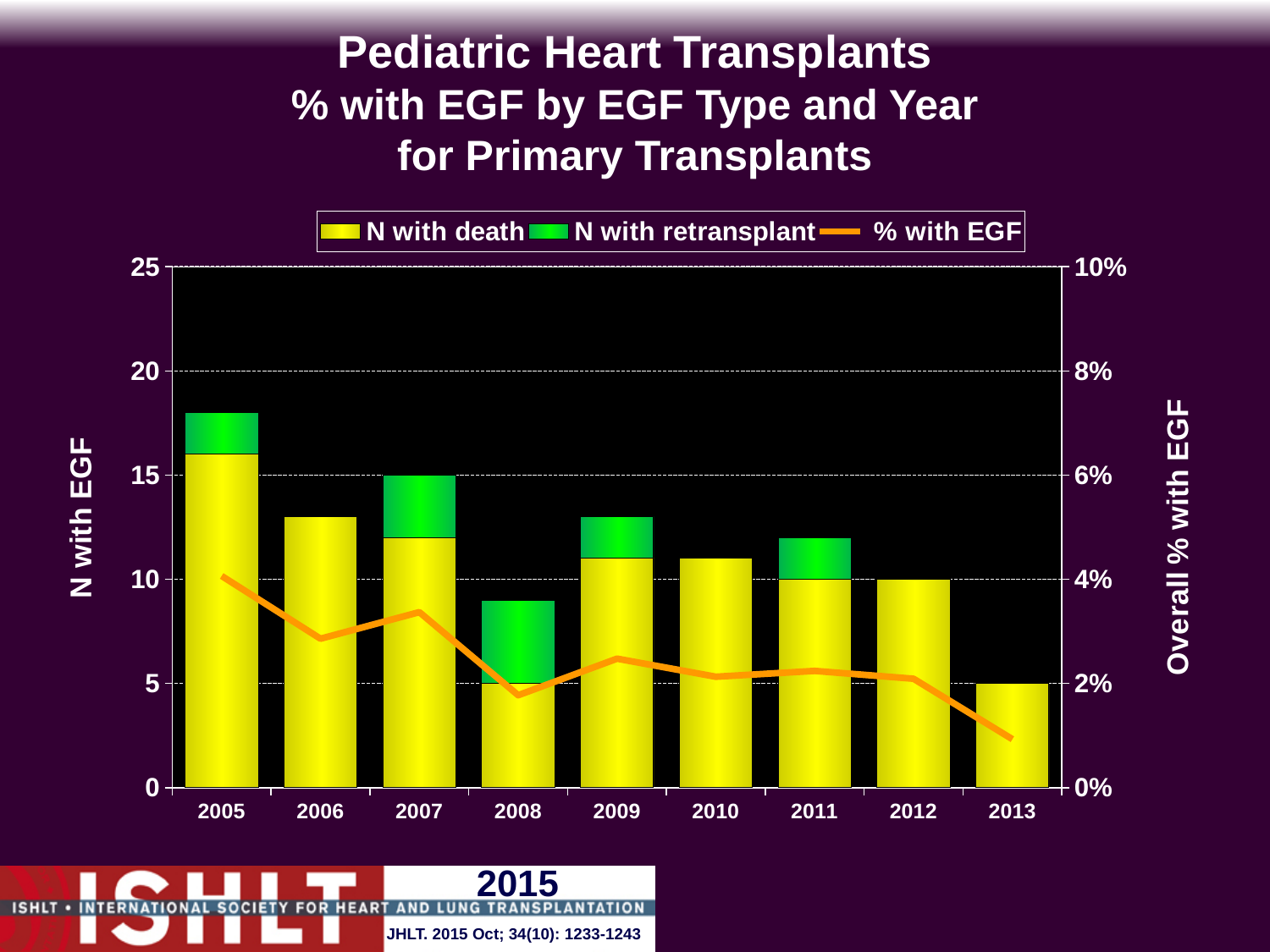
Does the % with EGF line generally rise or fall from 2005 to 2013? fall How many series does the legend list? 3 Which year has the tallest stacked bar (highest total N with EGF)? 2005 Which year has the larger total N with EGF, 2006 or 2010? 2006 Is the % with EGF value for 2005 greater or less than 3%? greater Is the % with EGF value for 2013 greater or less than 2%? less Which year has the shortest stacked bar (lowest total N with EGF)? 2013 What is the title of the right-hand vertical axis? Overall % with EGF How many years are shown along the x axis? 9 Is the total N with EGF for 2005 greater or less than 15? greater What kind of chart is shown on the slide? A bar chart combined with a line